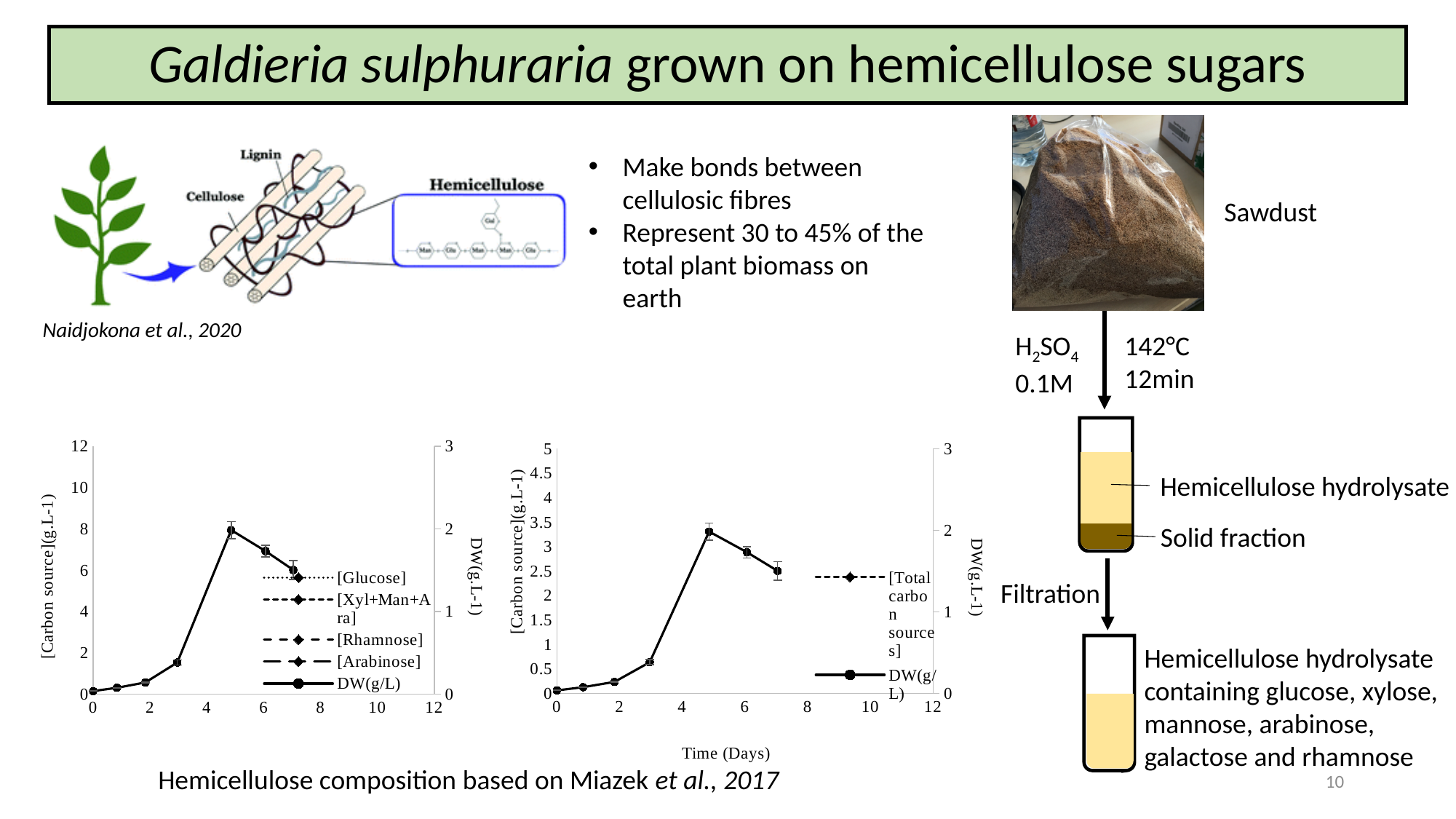
In the middle chart, is the DW(g/L) value at day 5 greater or less than 1? greater What is the x-axis title of the middle chart? Time (Days) What kind of chart is the middle chart on the slide? line chart In the middle chart, how many data points are plotted on the DW(g/L) line? 7 In the left chart, is the DW(g/L) value at day 0 greater or less than 1? less In the middle chart, does the DW(g/L) line rise or fall between day 0 and day 5? rise In the left chart, does the DW(g/L) line rise or fall between day 5 and day 7? fall How many series does the legend of the middle chart list? 2 In the left chart, how many data points are plotted on the DW(g/L) line? 7 How many series does the legend of the left chart list? 5 In the middle chart, which is larger, the DW(g/L) value at day 3 or at day 6? day 6 What kind of chart is the left chart on the slide? line chart